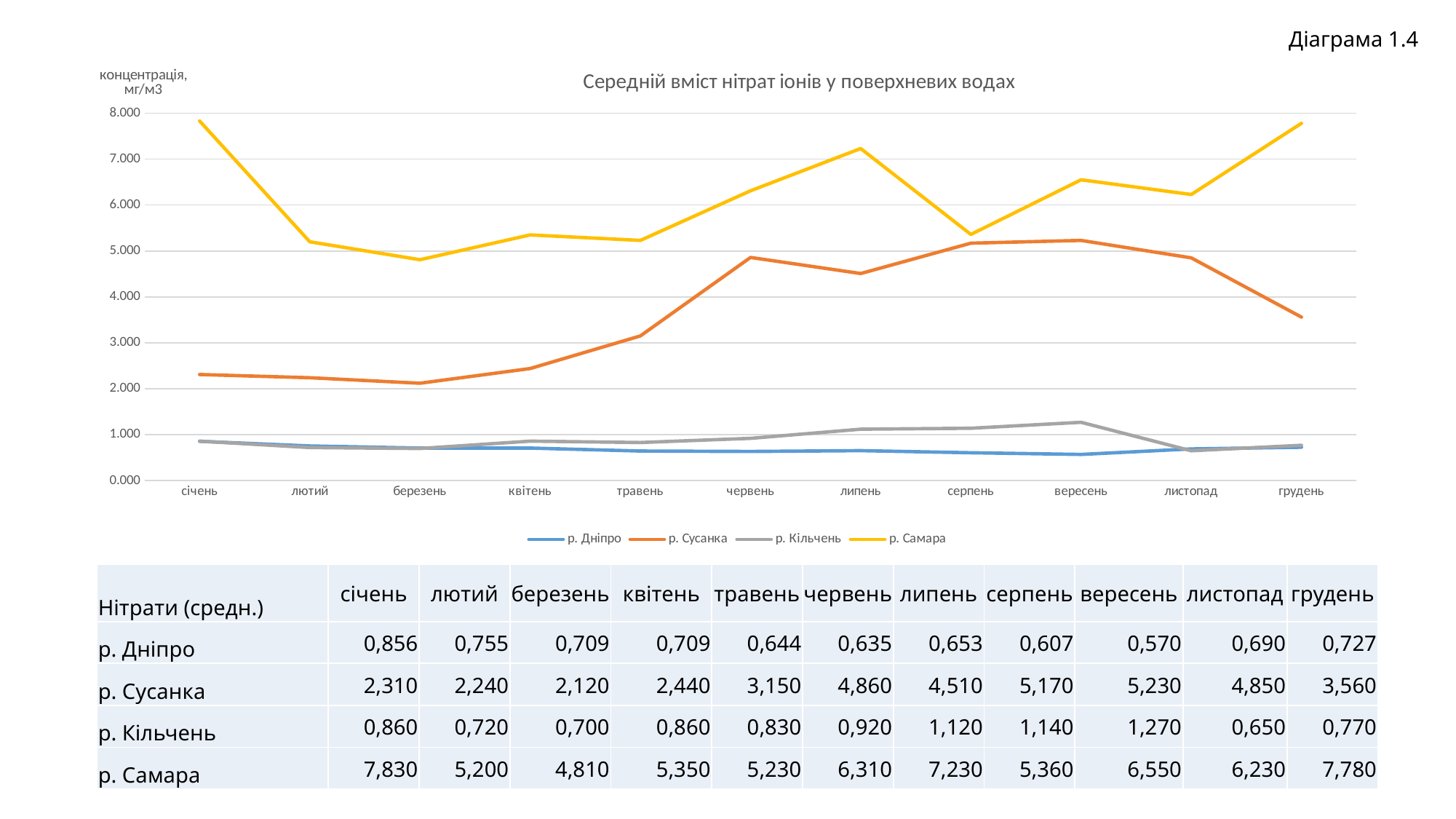
Does the р. Сусанка line generally rise or fall from квітень to червень? rise How many series does the legend of the chart list? 4 What is the difference between the р. Самара values for січень and лютий? 2,630 In which month does р. Кільчень reach its highest value? вересень What is the title of the chart? Середній вміст нітрат іонів у поверхневих водах In червень, which is larger: the value for р. Самара or the value for р. Сусанка? р. Самара Is the value for р. Сусанка in липень greater or less than 4.000? greater What kind of chart is shown on the slide? line chart How many months are plotted along the x axis of the chart? 11 What is the value for р. Сусанка in вересень? 5,230 What is the value for р. Самара in січень? 7,830 In which month does р. Дніпро have its lowest value? вересень